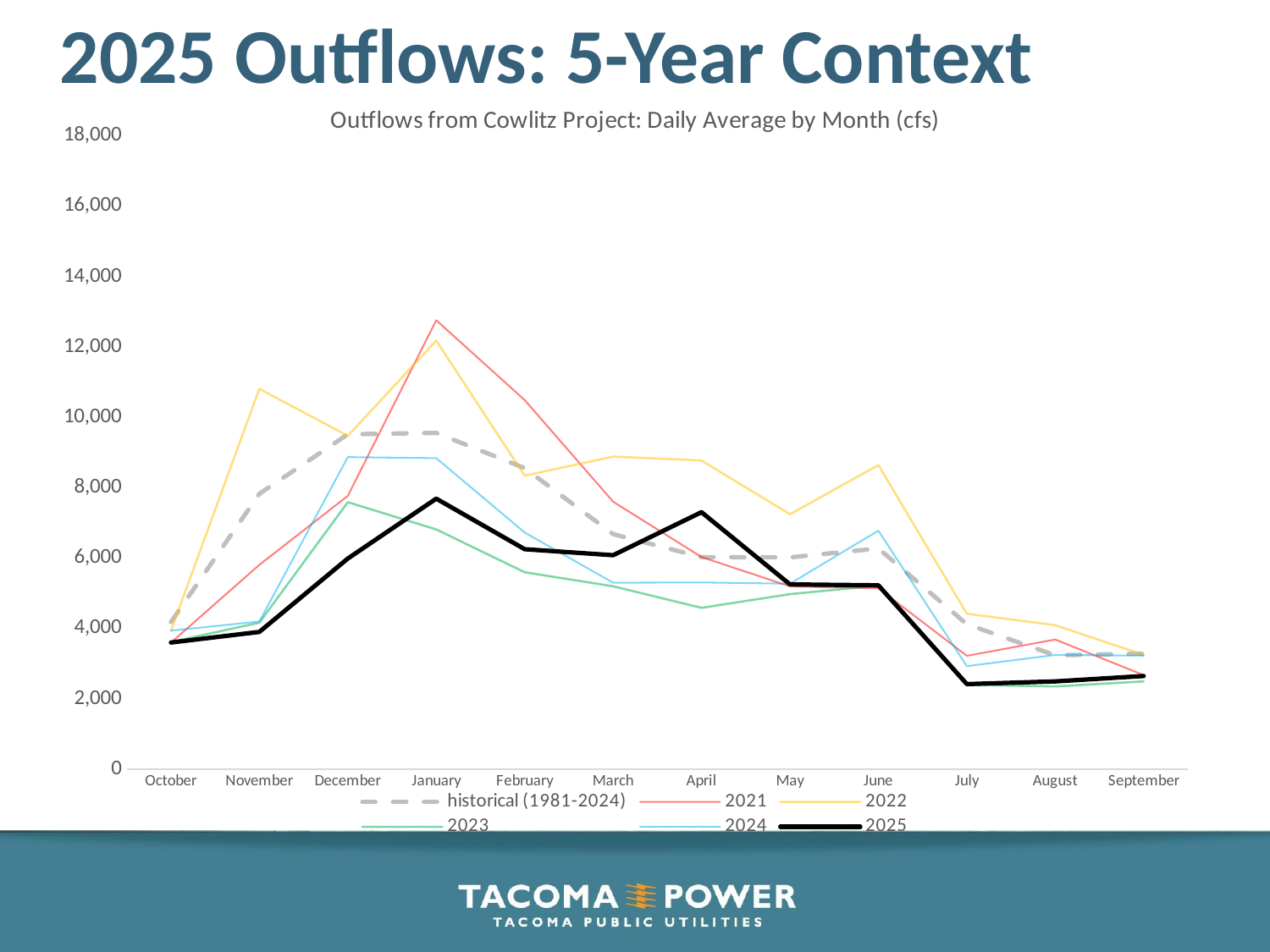
What kind of chart is shown on the slide? line chart In April, which is larger: the 2025 value or the historical (1981-2024) value? 2025 Is the 2025 value for January greater or less than 8,000? less In November, which is larger: the 2022 value or the 2025 value? 2022 How many months are shown along the x axis? 12 Is the 2021 value for January greater or less than 12,000? greater Which series has the highest value in January? 2021 In which month does the 2025 series reach its highest value? January Is the 2022 value for November greater or less than 10,000? greater How many series does the legend list? 6 Does the 2025 series rise or fall from June to July? fall Which series is drawn as a dashed line? historical (1981-2024)